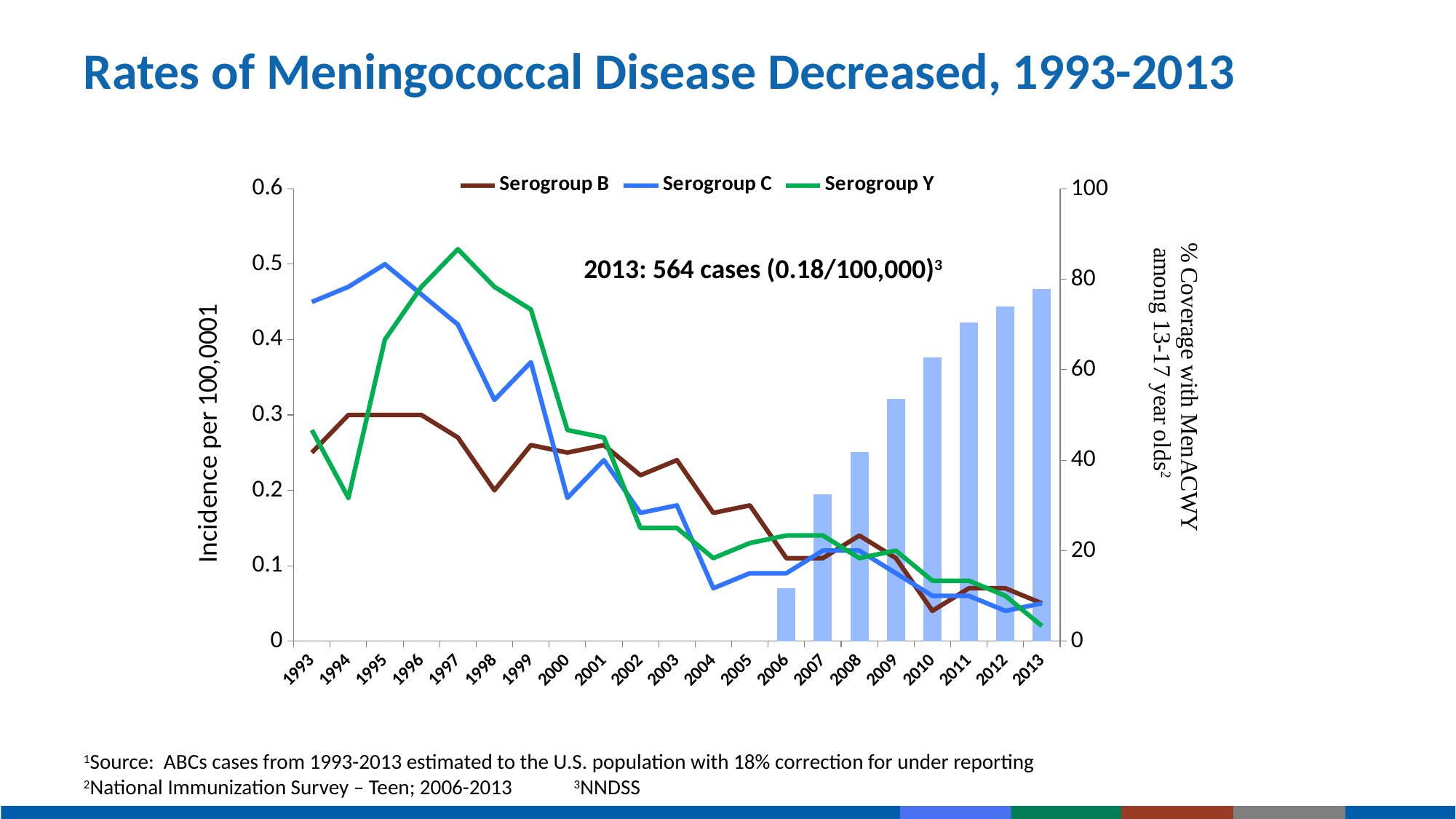
What annotation about 2013 is printed on the chart? 2013: 564 cases (0.18/100,000) How many years are shown along the x axis? 21 Is the incidence for Serogroup Y in 1997 greater or less than 0.5? greater Which serogroup has the lowest incidence in 1994? Serogroup Y Does the Serogroup C incidence rise or fall from 1995 to 2013? fall Do the MenACWY coverage bars rise or fall from 2006 to 2013? rise How many series does the legend list? 3 Is the incidence for Serogroup C in 2004 greater or less than 0.1? less What kind of chart is shown on the slide? line and bar chart Is the MenACWY coverage bar for 2013 greater or less than 60? greater In 1993, which is larger: the incidence for Serogroup C or for Serogroup B? Serogroup C Which serogroup has the highest incidence in 1997? Serogroup Y